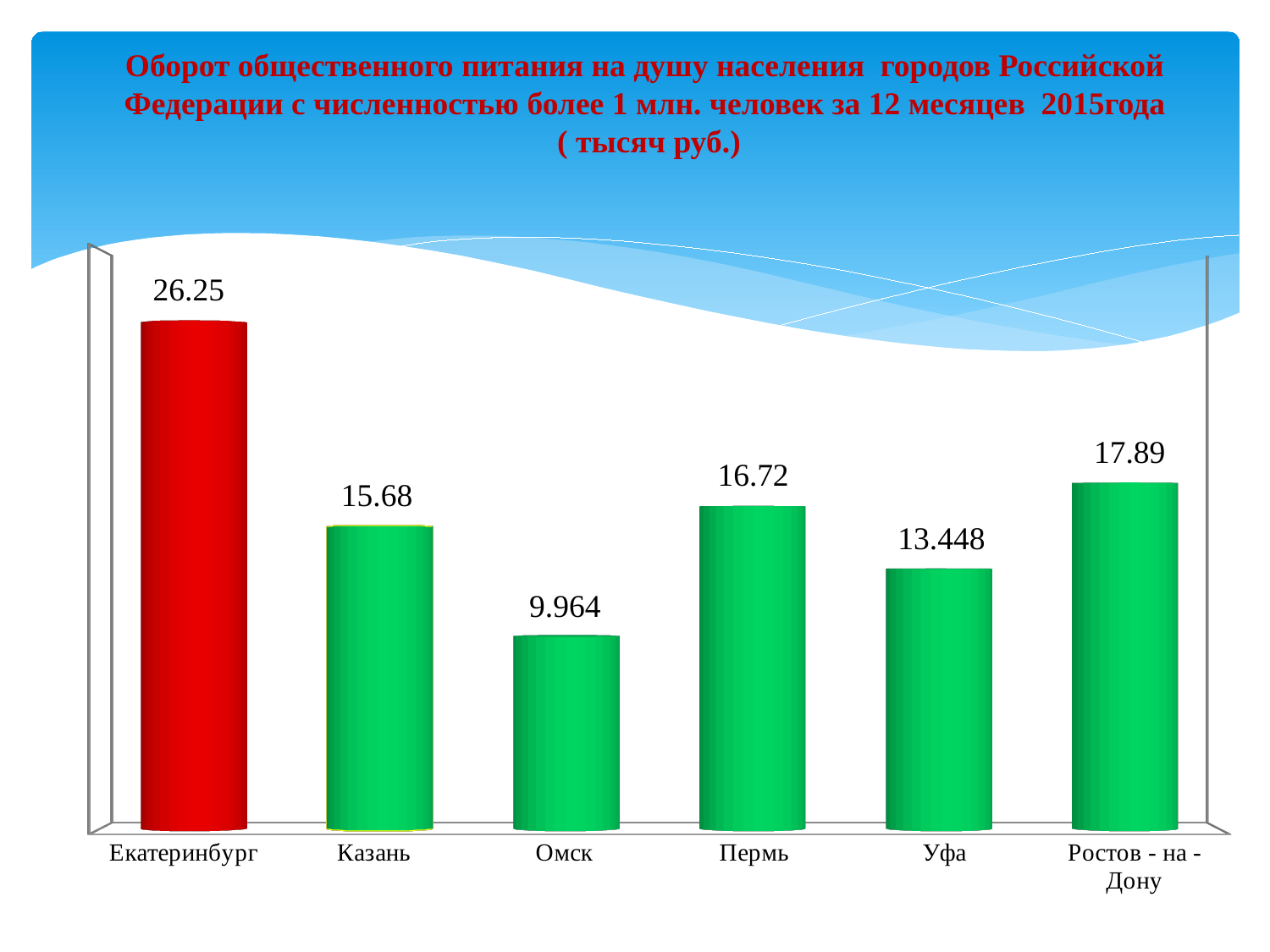
Which city has the lowest value? Омск What is the difference between the values for Пермь and Уфа? 3.272 What is the value for Омск? 9.964 How many cities are shown in the chart? 6 Which city has the highest value? Екатеринбург What is the value for Екатеринбург? 26.25 What is the difference between the values for Екатеринбург and Казань? 10.57 What kind of chart is shown on the slide? bar chart Which bar is coloured red rather than green? Екатеринбург Which is larger, the value for Пермь or the value for Казань? Пермь What is the value for Уфа? 13.448 What is the value for Ростов - на - Дону? 17.89